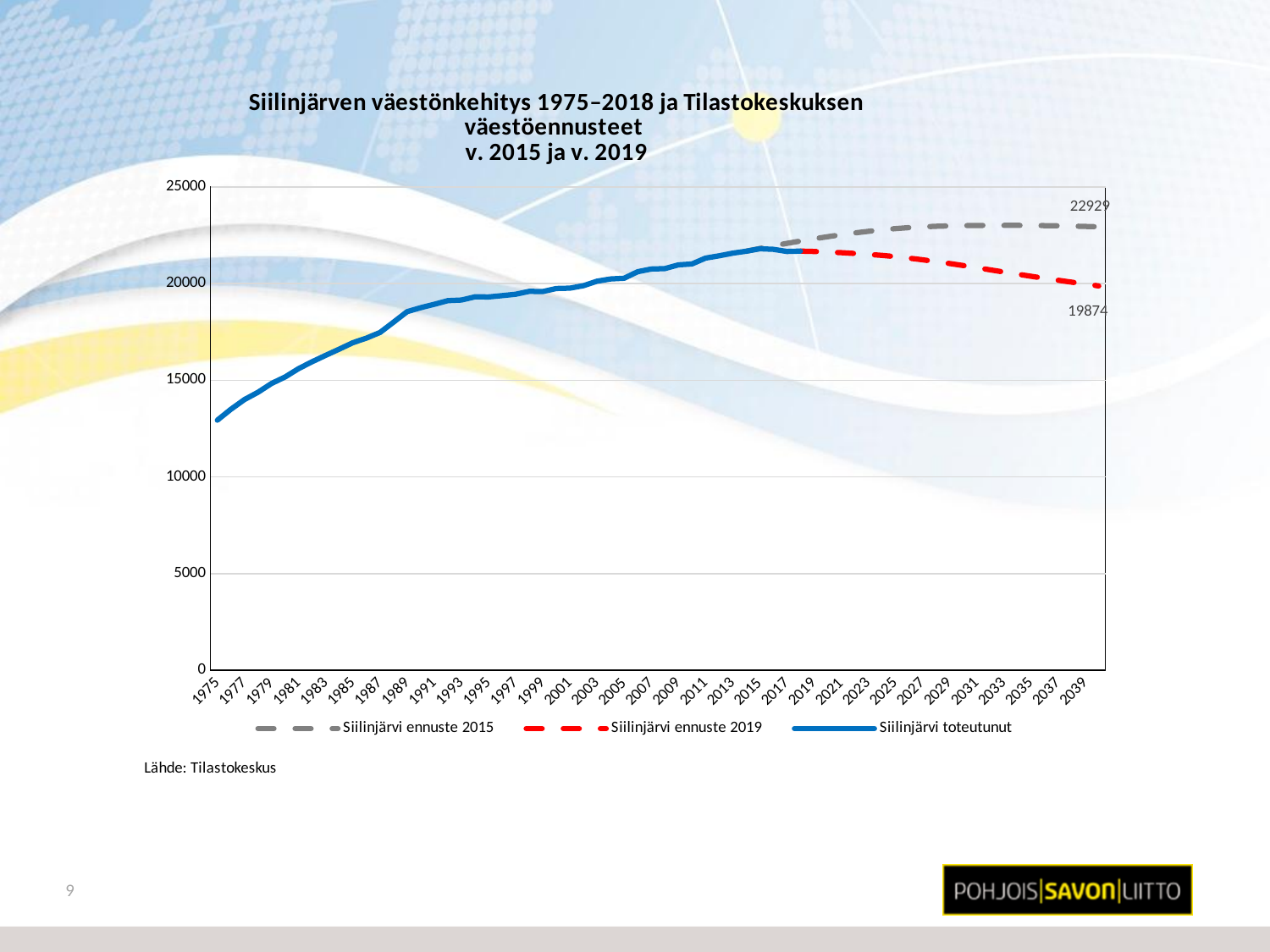
Which forecast series ends at a higher value, Siilinjärvi ennuste 2015 or Siilinjärvi ennuste 2019? Siilinjärvi ennuste 2015 What kind of chart is shown on the slide? line chart Is the value of Siilinjärvi toteutunut in 2015 greater or less than 20000? greater Is the value of Siilinjärvi toteutunut in 1975 greater or less than 15000? less Does the Siilinjärvi toteutunut series rise or fall from 1975 to 2018? rise What source is cited below the chart? Lähde: Tilastokeskus How many series does the legend list? 3 What is the labelled end value of the Siilinjärvi ennuste 2015 series? 22929 What is the labelled end value of the Siilinjärvi ennuste 2019 series? 19874 What colour is the Siilinjärvi toteutunut line? blue Does the Siilinjärvi ennuste 2019 series rise or fall after 2019? fall What is the difference between the labelled end values of the 2015 forecast (22929) and the 2019 forecast (19874)? 3055